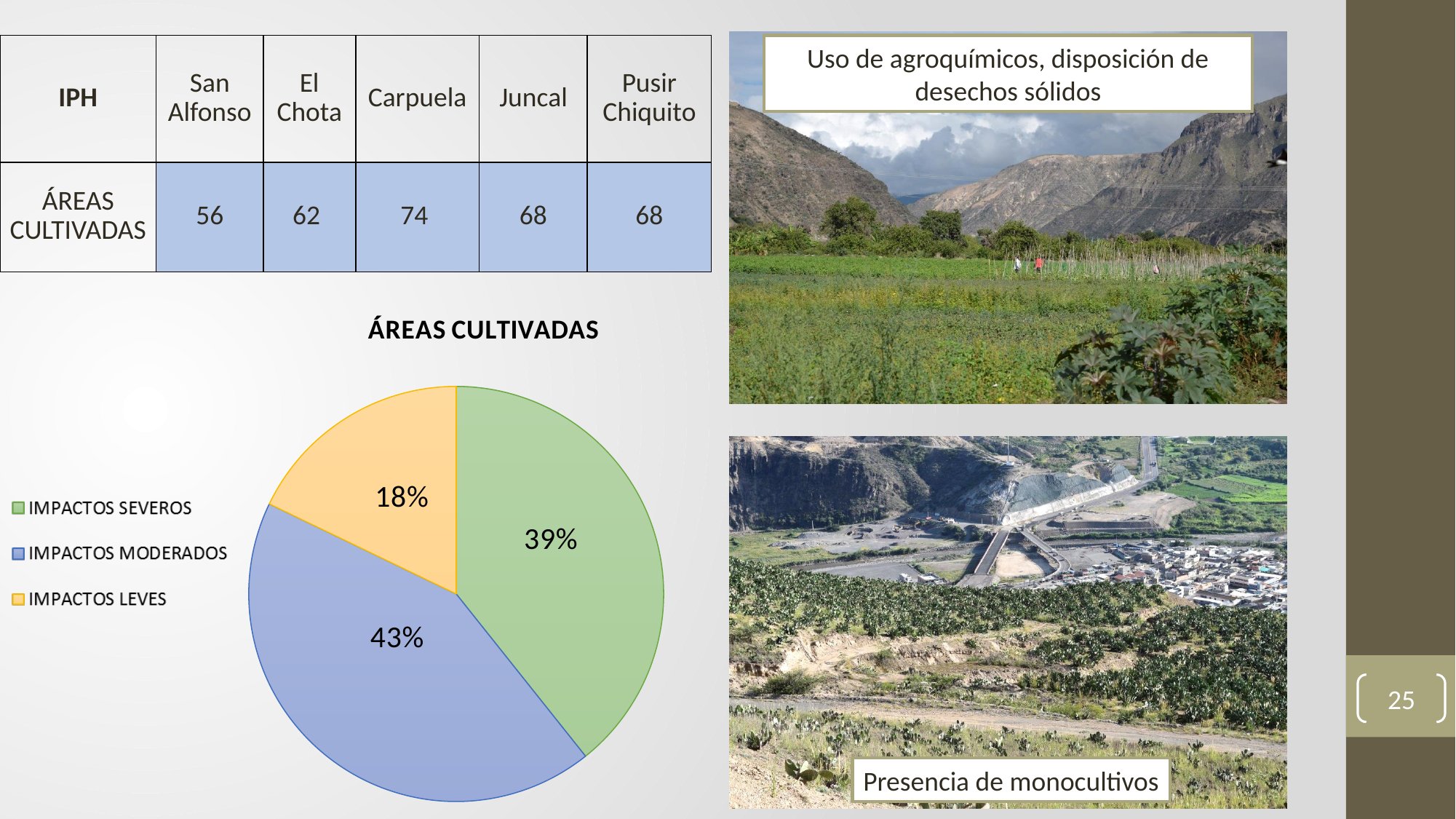
How many entries does the legend of the pie chart list? 3 What is the difference in percentage points between IMPACTOS MODERADOS and IMPACTOS SEVEROS in the pie chart? 4 Which is larger in the pie chart, IMPACTOS SEVEROS or IMPACTOS LEVES? IMPACTOS SEVEROS What colour is the IMPACTOS LEVES slice in the pie chart? yellow What type of chart is shown under the title ÁREAS CULTIVADAS? pie chart Which category has the largest slice in the pie chart? IMPACTOS MODERADOS What share of the pie chart is IMPACTOS SEVEROS? 39% What share of the pie chart is IMPACTOS LEVES? 18% What is the title of the pie chart? ÁREAS CULTIVADAS How many slices does the pie chart have? 3 Which category has the smallest slice in the pie chart? IMPACTOS LEVES What share of the pie chart is IMPACTOS MODERADOS? 43%